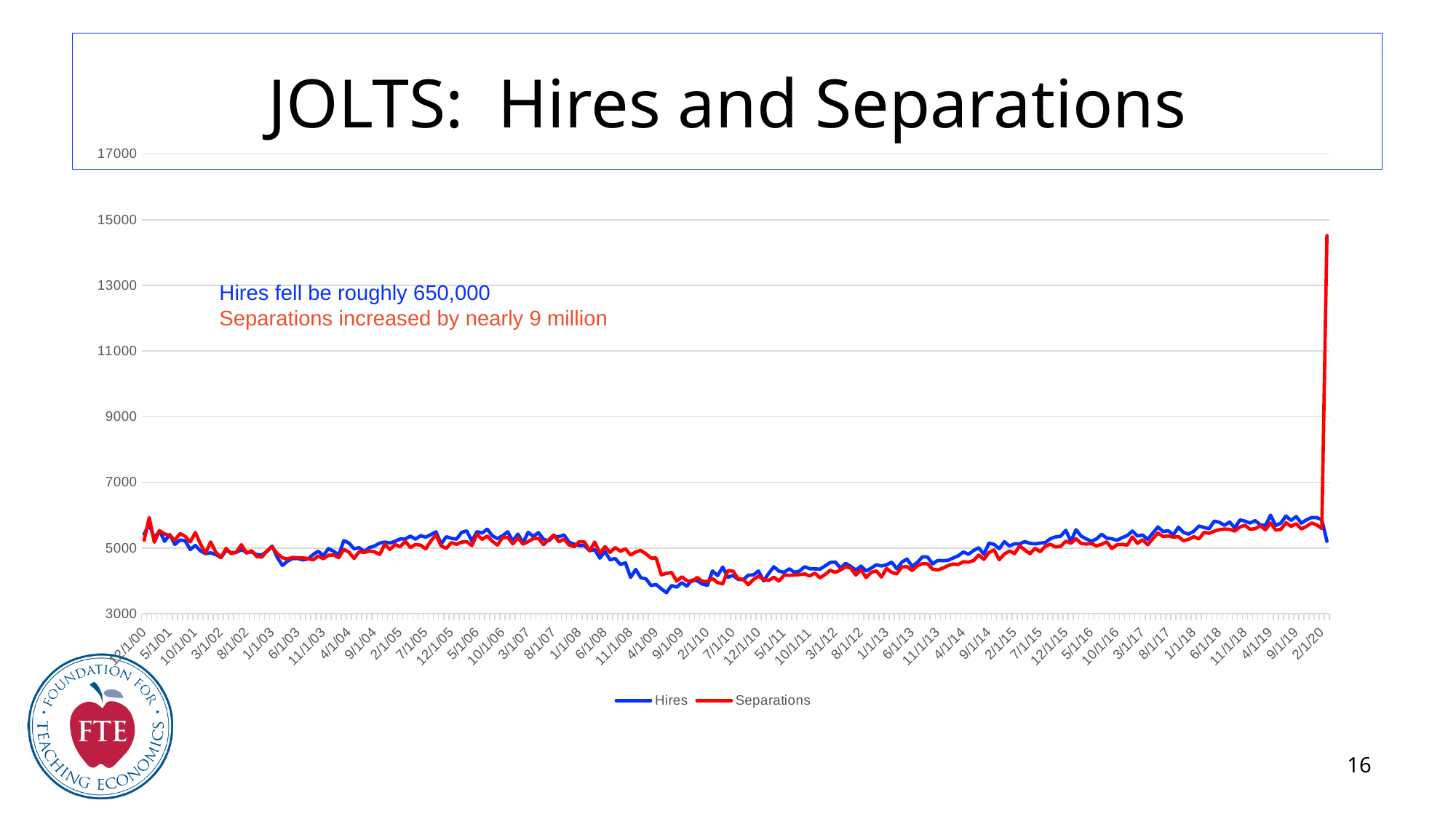
Is the peak value of the Separations series at the right end of the chart greater or less than 13000? greater What is the title of the chart? JOLTS: Hires and Separations Around 4/1/09, which series has the larger value, Hires or Separations? Separations How many series does the legend list? 2 Is the value of Hires around 4/1/09 greater or less than 5000? less At the final point on the chart, which series has the larger value, Hires or Separations? Separations What kind of chart is shown on the slide? Line chart Which series is drawn in red? Separations Do Hires rise or fall between 1/1/08 and 4/1/09? fall Is the value of Separations around 2/1/10 greater or less than 5000? less Which series reaches the highest value anywhere on the chart? Separations